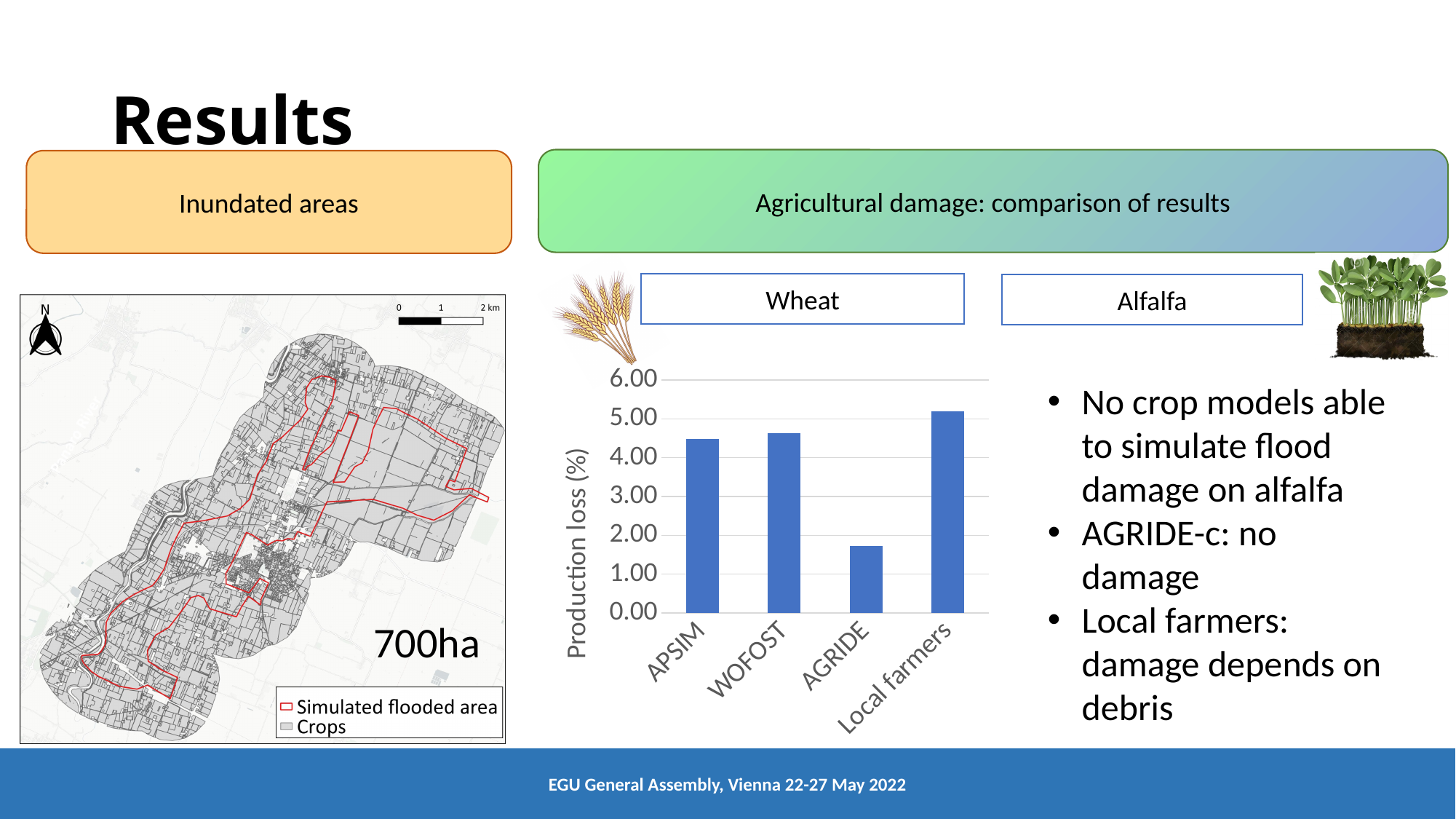
In the Wheat chart, is the production loss for AGRIDE greater or less than 1.00? greater In the Wheat chart, which has a larger production loss, WOFOST or AGRIDE? WOFOST In the Wheat chart, is the production loss for APSIM greater or less than 4.00? greater In the Wheat chart, is the production loss for Local farmers greater or less than 5.00? greater Which category has the lowest production loss in the Wheat chart? AGRIDE In the Wheat chart, which has a larger production loss, Local farmers or AGRIDE? Local farmers Which category has the highest production loss in the Wheat chart? Local farmers What kind of chart is shown under the Wheat heading? bar chart What is the label on the vertical axis of the Wheat chart? Production loss (%) How many categories are plotted on the Wheat production loss chart? 4